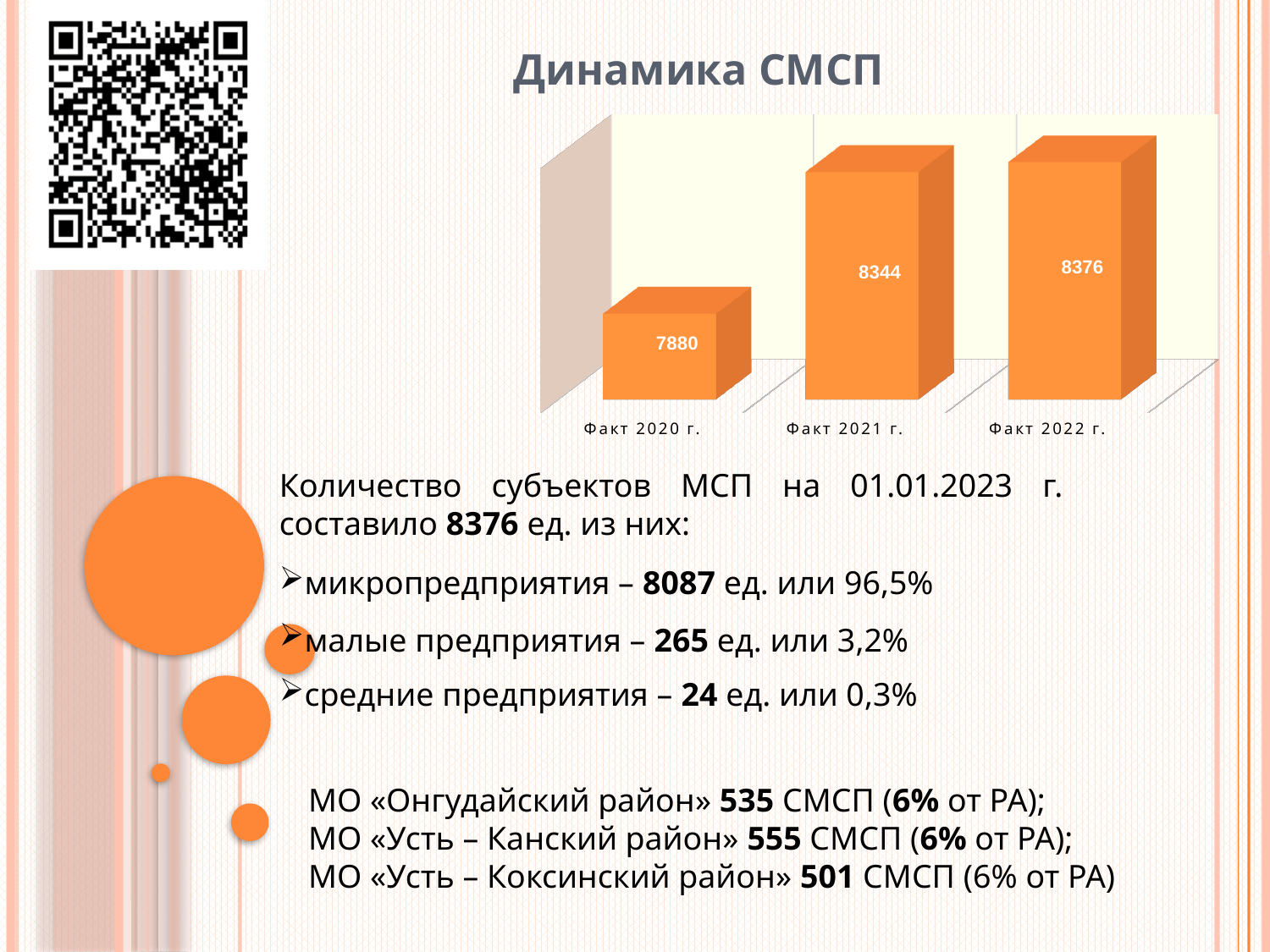
What is the value for Факт 2022 г.? 8376 Do the values rise or fall from Факт 2020 г. to Факт 2022 г.? rise Which is larger, the value for Факт 2020 г. or the value for Факт 2021 г.? Факт 2021 г. What kind of chart is shown on the slide? bar chart What is the difference between the values for Факт 2021 г. and Факт 2020 г.? 464 Which category has the highest value? Факт 2022 г. What is the title of the chart? Динамика СМСП Which category has the lowest value? Факт 2020 г. What is the value for Факт 2020 г.? 7880 What is the value for Факт 2021 г.? 8344 What is the difference between the values for Факт 2022 г. and Факт 2021 г.? 32 How many categories are shown on the chart? 3